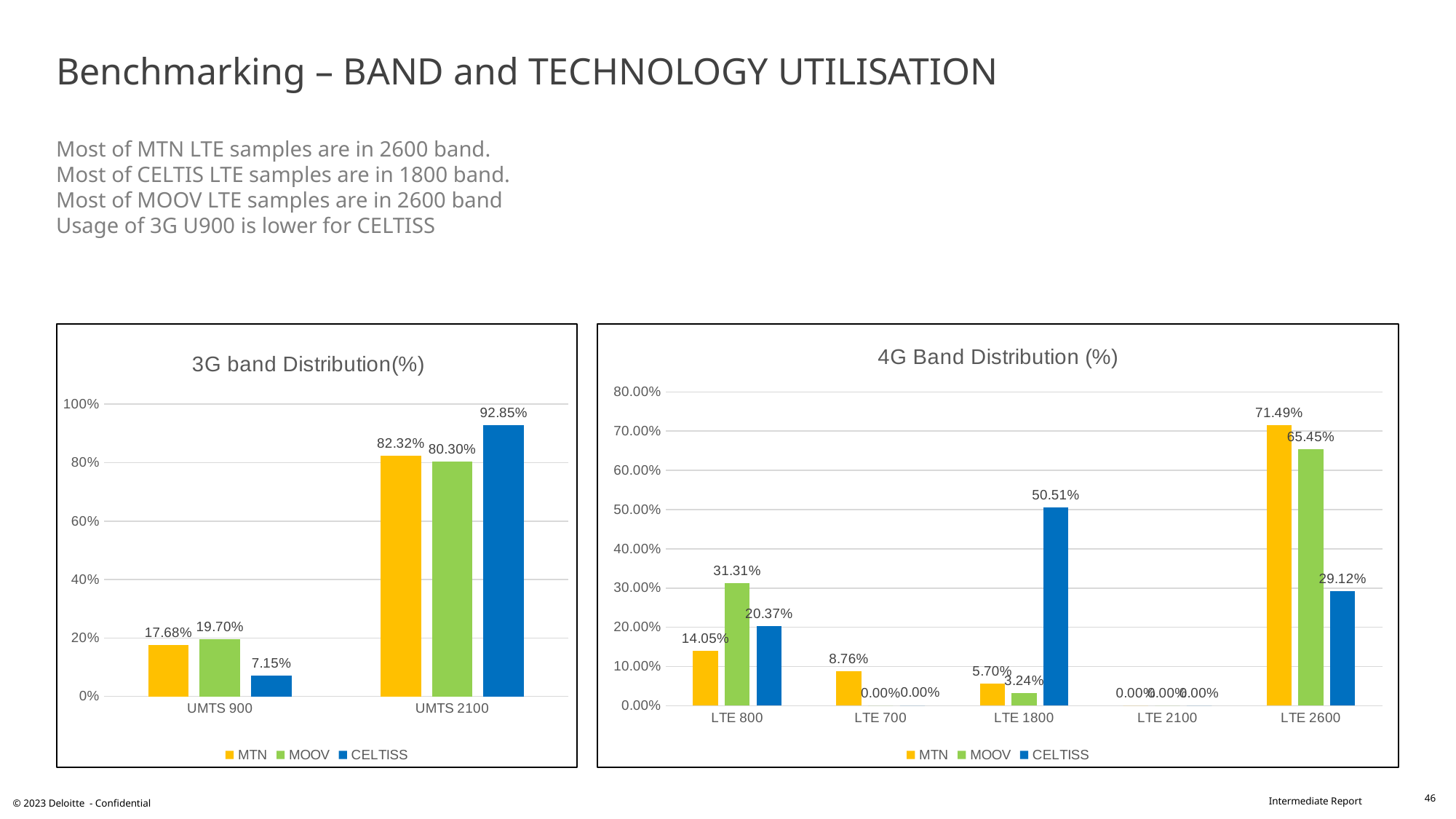
In the 3G band Distribution(%) chart, which operator has the lowest value at UMTS 900? CELTISS In the 4G Band Distribution (%) chart, which operator has the highest value at LTE 800? MOOV In the 3G band Distribution(%) chart, what is the value for MOOV at UMTS 900? 19.70% In the 4G Band Distribution (%) chart, which is larger at LTE 2600: MTN or CELTISS? MTN In the 3G band Distribution(%) chart, what is the difference between the CELTISS and MTN values at UMTS 2100? 10.53% In the 4G Band Distribution (%) chart, what is the difference between the MOOV and MTN values at LTE 800? 17.26% In the 3G band Distribution(%) chart, what is the value for CELTISS at UMTS 2100? 92.85% How many band categories are shown on the x axis of the 4G Band Distribution (%) chart? 5 What type of chart is the 4G Band Distribution (%) chart? Bar chart In the 4G Band Distribution (%) chart, what is the value for MTN at LTE 2600? 71.49% How many series does the legend of the 3G band Distribution(%) chart list? 3 In the 4G Band Distribution (%) chart, what is the value for CELTISS at LTE 1800? 50.51%